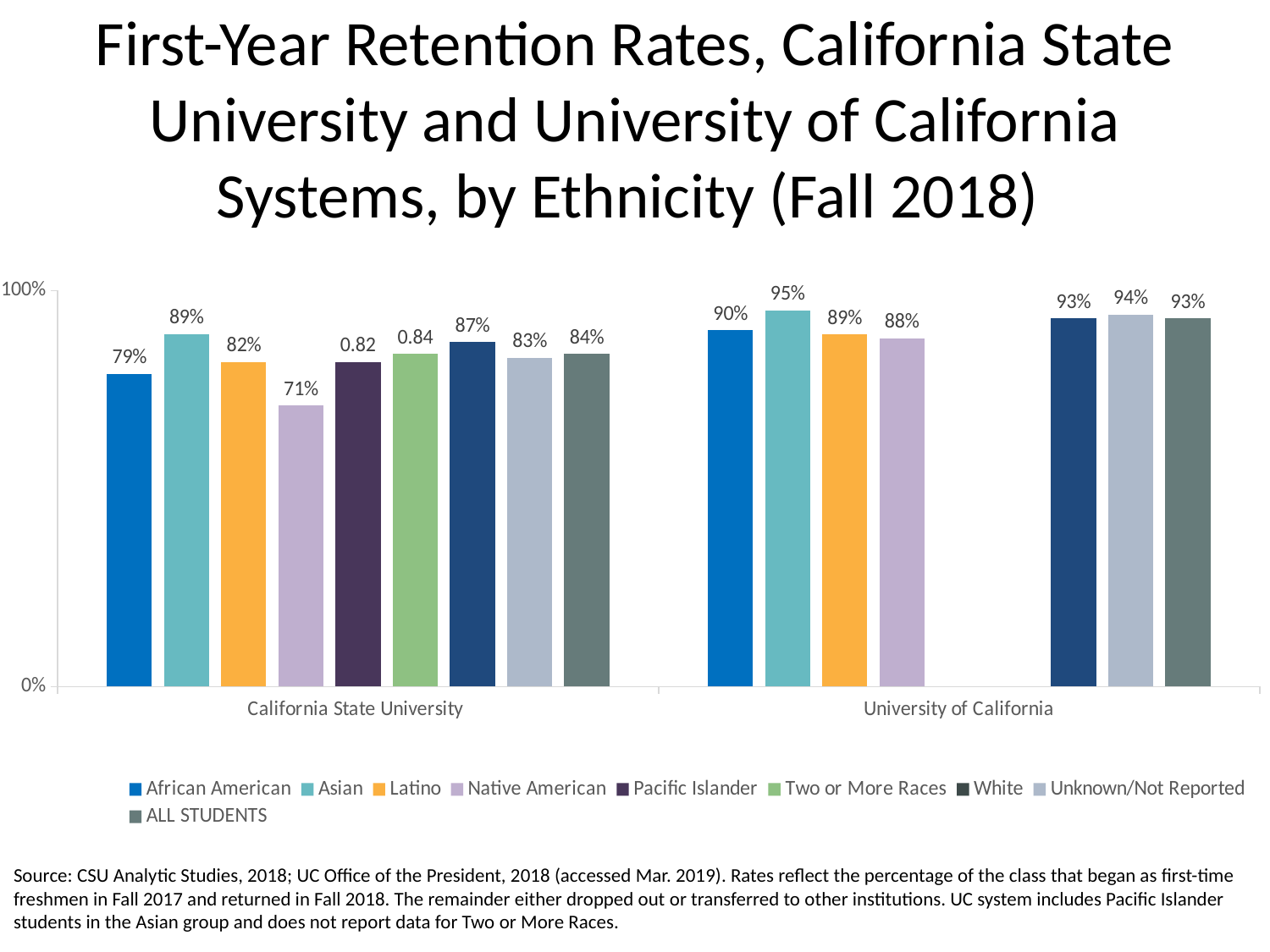
What is the difference between the Asian and African American retention rates at California State University? 10% Which is higher: the White retention rate at California State University or the Latino retention rate at University of California? Latino retention rate at University of California What is the retention rate for ALL STUDENTS at University of California? 93% What kind of chart is shown on the slide? Bar chart Which ethnic group has the highest retention rate at University of California? Asian What is the first-year retention rate for Asian students at University of California? 95% How many bars are shown for the University of California group? 7 Which ethnic group has the lowest retention rate at California State University? Native American How many series does the legend list? 9 What is the difference between the Unknown/Not Reported retention rate at University of California and at California State University? 11% What is the first-year retention rate for African American students at California State University? 79% What is the retention rate for Native American students at California State University? 71%